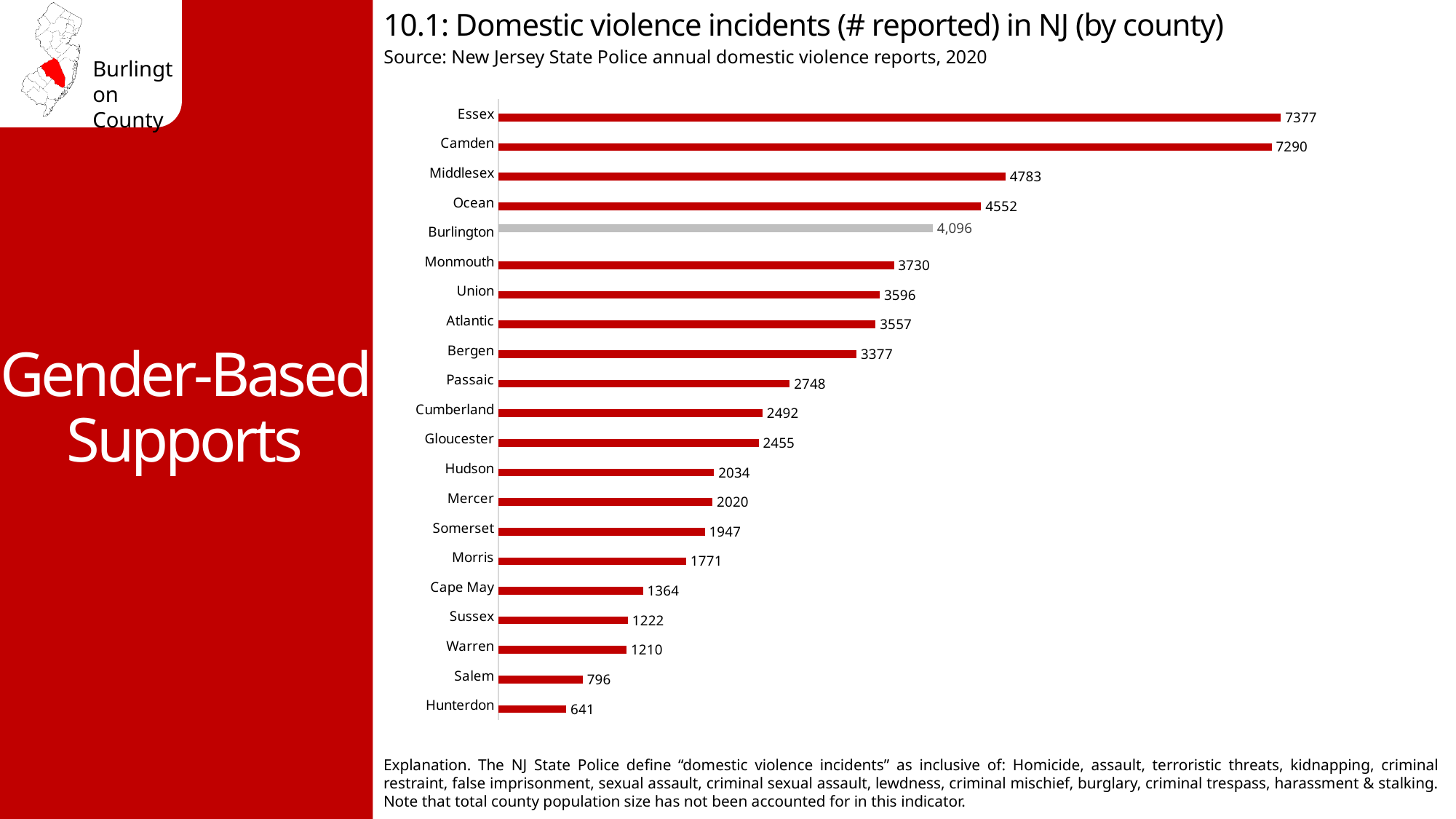
Which county's bar is shown in grey rather than red? Burlington What is the difference between the values for Middlesex and Ocean? 231 What is the difference between the values for Essex and Camden? 87 Which has fewer reported domestic violence incidents, Salem or Sussex? Salem Which has more reported domestic violence incidents, Passaic or Bergen? Bergen What is the number of domestic violence incidents reported for Monmouth? 3730 What is the number of domestic violence incidents reported for Burlington? 4,096 Which county has the lowest number of reported domestic violence incidents? Hunterdon How many counties are shown in the chart? 21 What type of chart is used to show domestic violence incidents by county? Bar chart Which county has the highest number of reported domestic violence incidents? Essex What is the source cited for the chart data? New Jersey State Police annual domestic violence reports, 2020